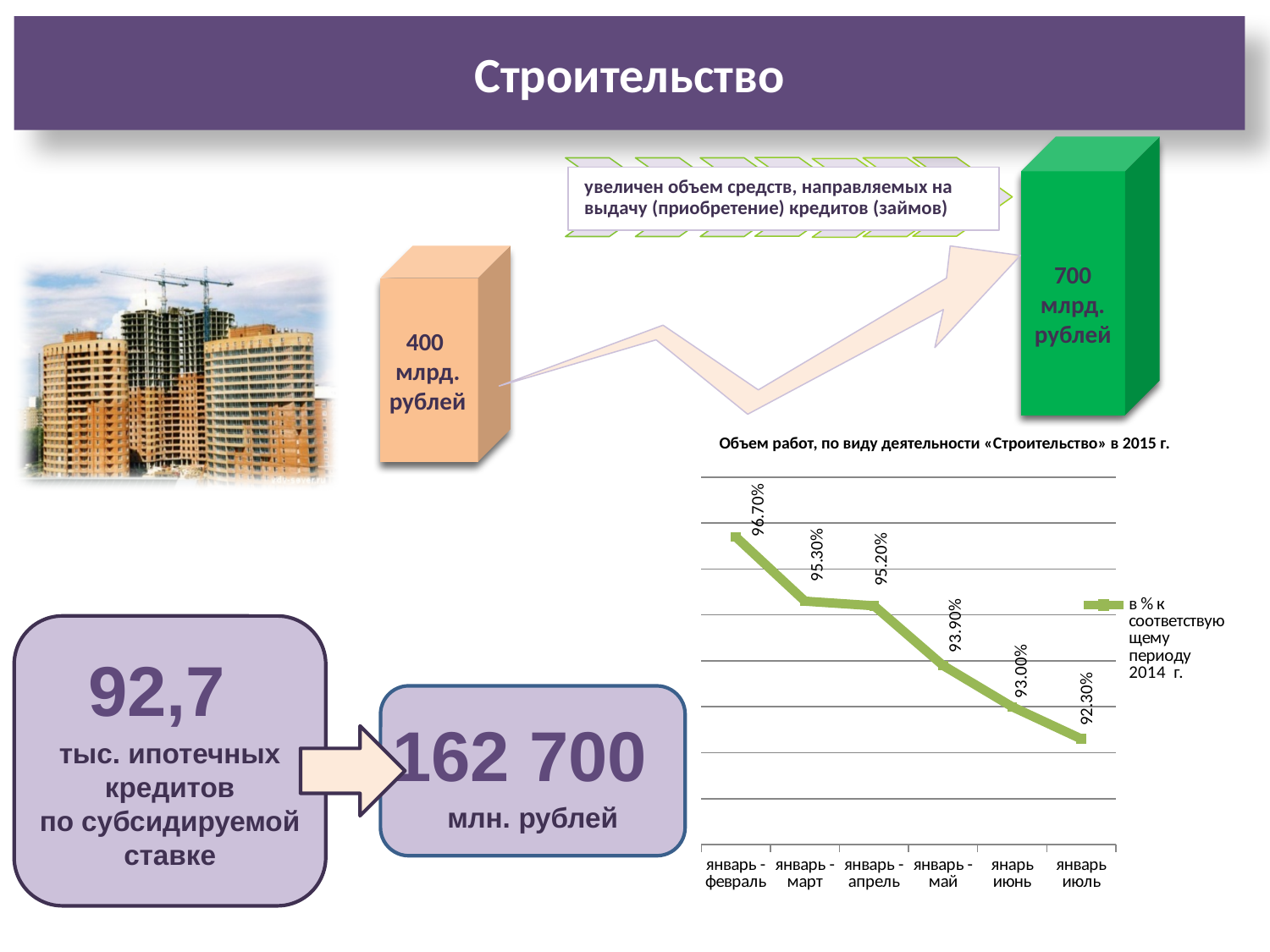
How many data points are plotted in the chart «Объем работ, по виду деятельности «Строительство» в 2015 г.»? 6 In the chart «Объем работ, по виду деятельности «Строительство» в 2015 г.», which is larger: the value for январь - апрель or the value for янарь июнь? январь - апрель What is the value for январь - май in the chart «Объем работ, по виду деятельности «Строительство» в 2015 г.»? 93.90% Which period has the highest value in the chart «Объем работ, по виду деятельности «Строительство» в 2015 г.»? январь - февраль In the chart «Объем работ, по виду деятельности «Строительство» в 2015 г.», what is the difference between the values for январь - февраль and январь июль? 4.40% Do the values in the chart «Объем работ, по виду деятельности «Строительство» в 2015 г.» rise or fall from left to right? fall Which period has the lowest value in the chart «Объем работ, по виду деятельности «Строительство» в 2015 г.»? январь июль What type of chart is shown under the title «Объем работ, по виду деятельности «Строительство» в 2015 г.»? line chart What is the value for январь - март in the chart «Объем работ, по виду деятельности «Строительство» в 2015 г.»? 95.30% What is the value for январь июль in the chart «Объем работ, по виду деятельности «Строительство» в 2015 г.»? 92.30% How many series does the legend of the chart «Объем работ, по виду деятельности «Строительство» в 2015 г.» list? 1 What is the value for январь - февраль in the chart «Объем работ, по виду деятельности «Строительство» в 2015 г.»? 96.70%